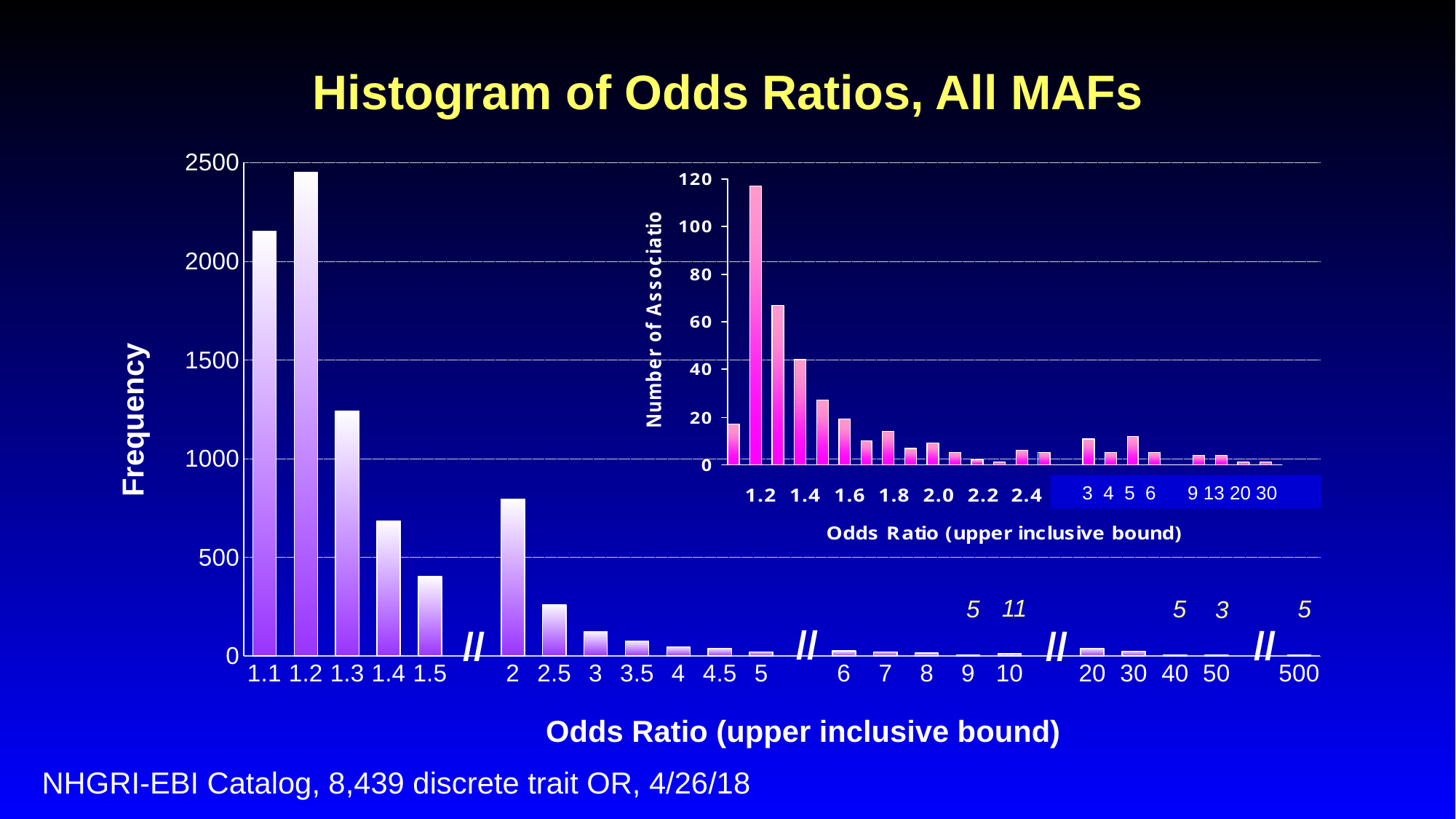
On the main chart, what is the value for the odds ratio bin 50? 3 On the main chart, is the frequency for bin 1.4 greater or less than 1000? less How many odds ratio bins are shown on the x axis of the main chart? 22 What kind of chart is the main chart on the slide? bar chart On the main chart, which odds ratio bin has the highest frequency? 1.2 On the inset chart, is the number of associations for bin 1.2 greater or less than 100? greater On the main chart, what is the value for the odds ratio bin 10? 11 On the main chart, which is larger, the frequency for bin 1.1 or bin 1.3? 1.1 On the main chart, is the frequency for bin 1.1 greater or less than 2000? greater On the main chart, what is the value for the odds ratio bin 500? 5 On the main chart, what is the difference between the values for bins 10 and 9? 6